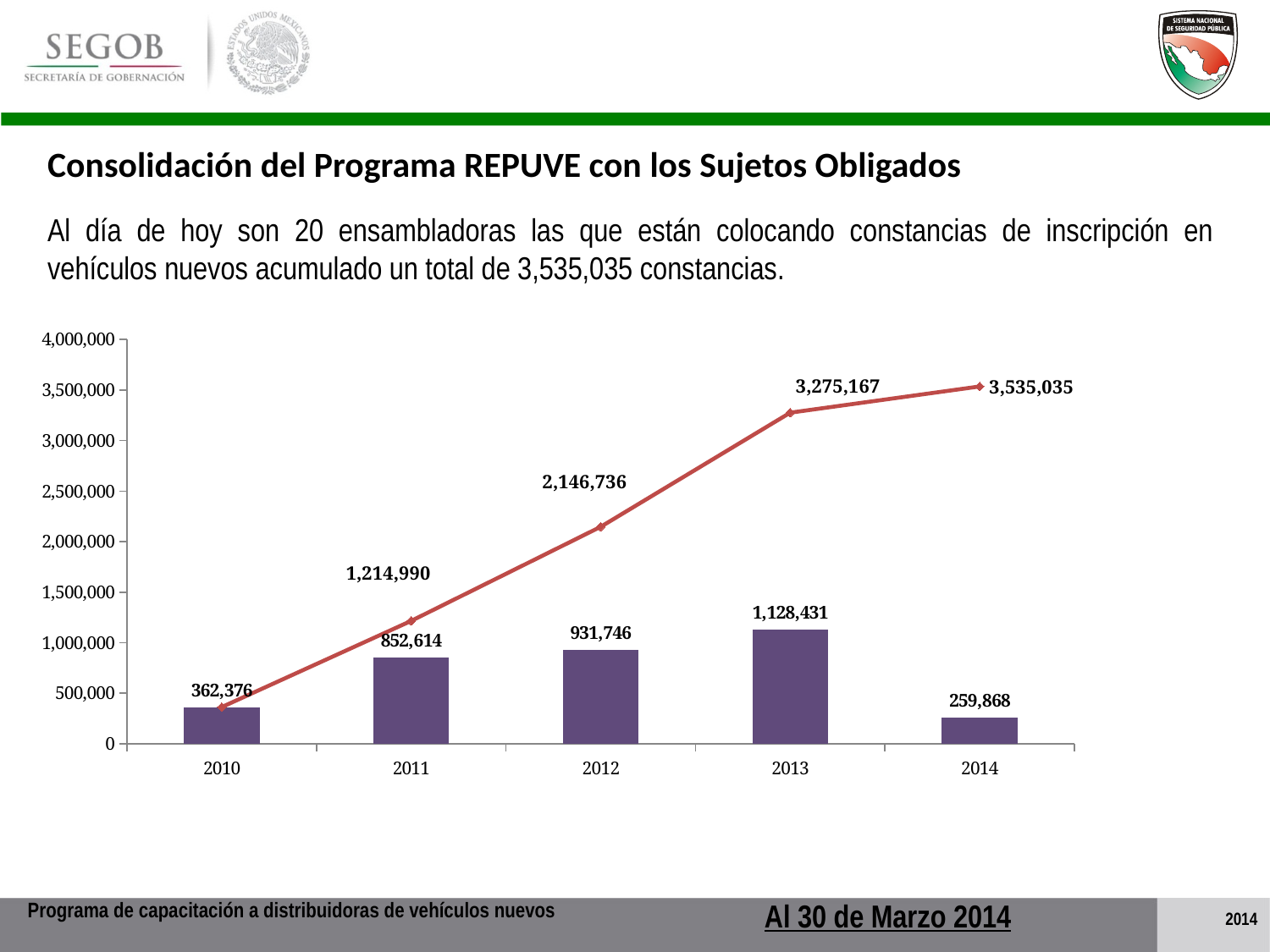
What is the difference between the bar values for 2013 and 2012? 196,685 Does the line series rise or fall from 2010 to 2014? rise By how much does the line value increase from 2013 to 2014? 259,868 Is the line value for 2013 greater or less than 3,000,000? greater Which year has the highest bar? 2013 What is the value of the bar for 2010? 362,376 What value does the line series show for 2012? 2,146,736 Which year has the lowest bar? 2014 What is the value of the bar for 2013? 1,128,431 How many years are shown on the x axis? 5 Which bar is larger, 2011 or 2012? 2012 What is the final value of the line series, at 2014? 3,535,035